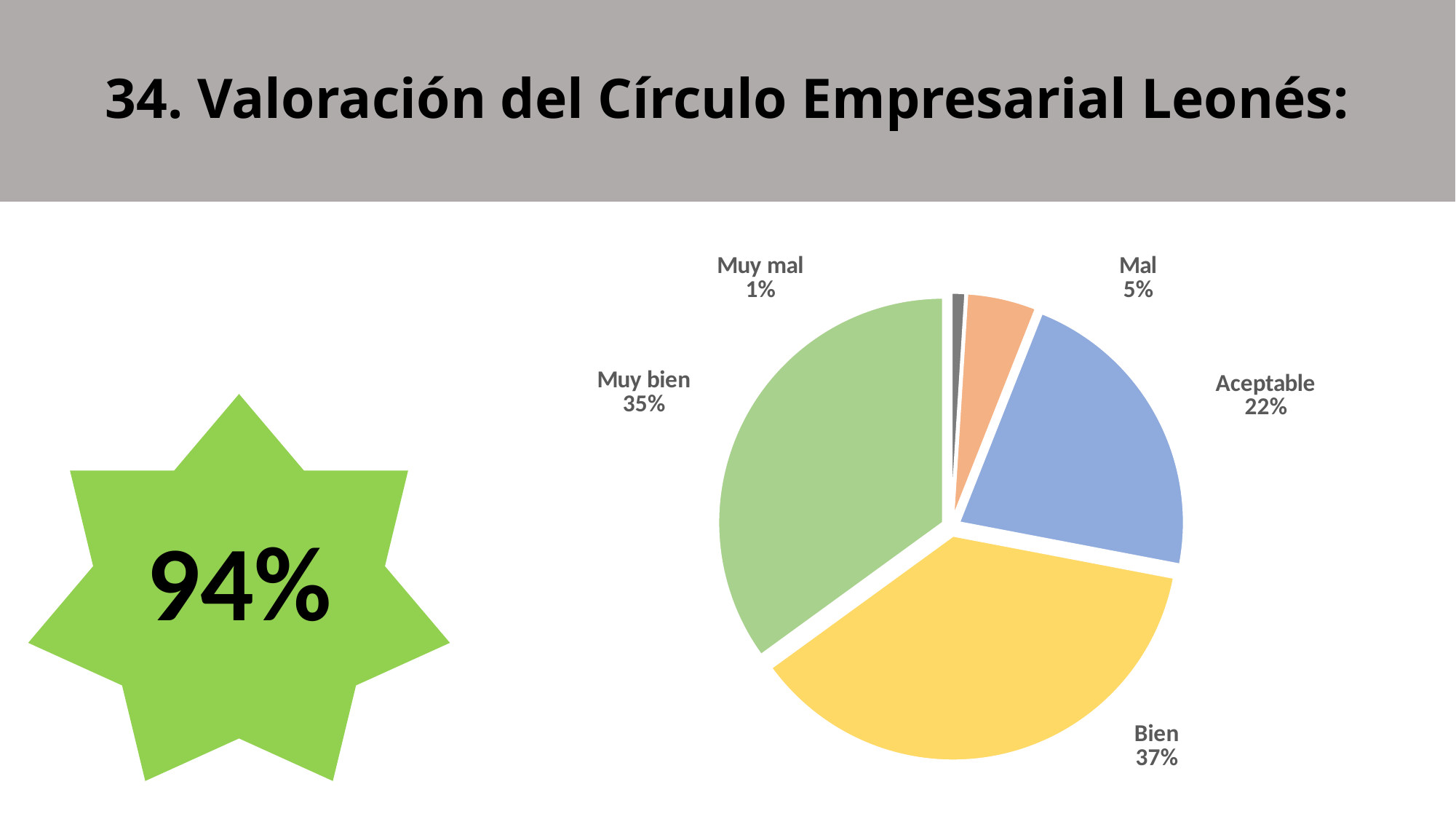
What percentage of the pie is labelled "Muy mal"? 1% What colour is the "Bien" slice of the pie? Yellow What percentage of the pie is labelled "Mal"? 5% What percentage of the pie is labelled "Bien"? 37% Which category has the smallest share of the pie? Muy mal What percentage of the pie is labelled "Aceptable"? 22% What type of chart is shown on the slide? Pie chart How many slices does the pie chart have? 5 What is the difference in percentage points between "Bien" and "Aceptable"? 15 Which category has the largest share of the pie? Bien Which is larger, the share for "Aceptable" or the share for "Mal"? Aceptable What percentage of the pie is labelled "Muy bien"? 35%